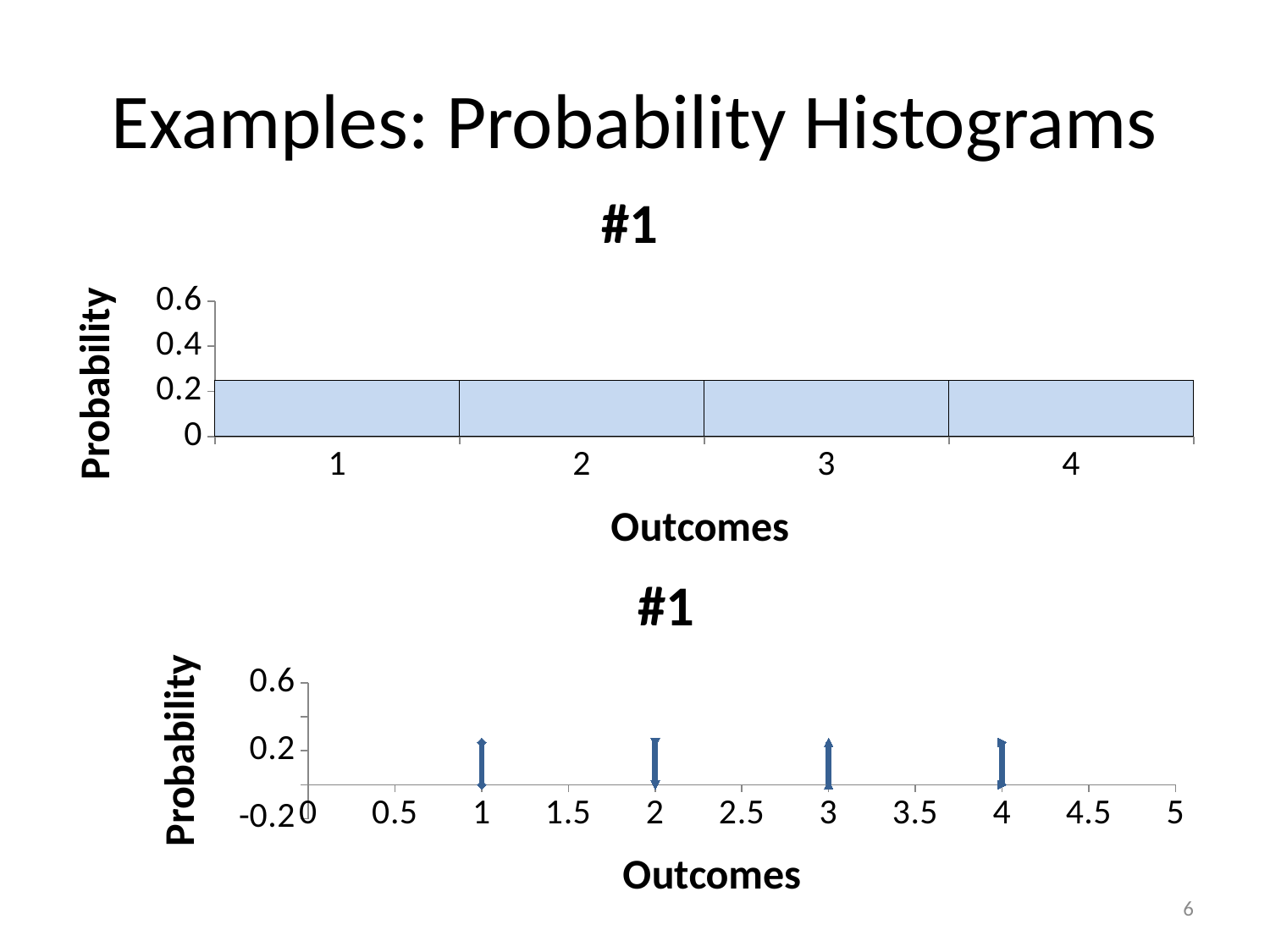
In the top chart, is the value for outcome 1 greater or less than 0.4? less In the bottom chart, is the value at outcome 2 greater or less than 0? greater What kind of chart is the top chart on the slide? bar chart What is the x-axis title of the top chart? Outcomes In the top chart, is the value for outcome 4 greater or less than 0.6? less In the top chart, do the bar heights rise, fall, or stay the same from outcome 1 to outcome 4? stay the same What is the title of the top chart? #1 What is the highest value shown on the x-axis of the bottom chart? 5 How many outcome points are plotted in the bottom chart? 4 How many bars does the top chart show? 4 What is the lowest value shown on the y-axis of the bottom chart? -0.2